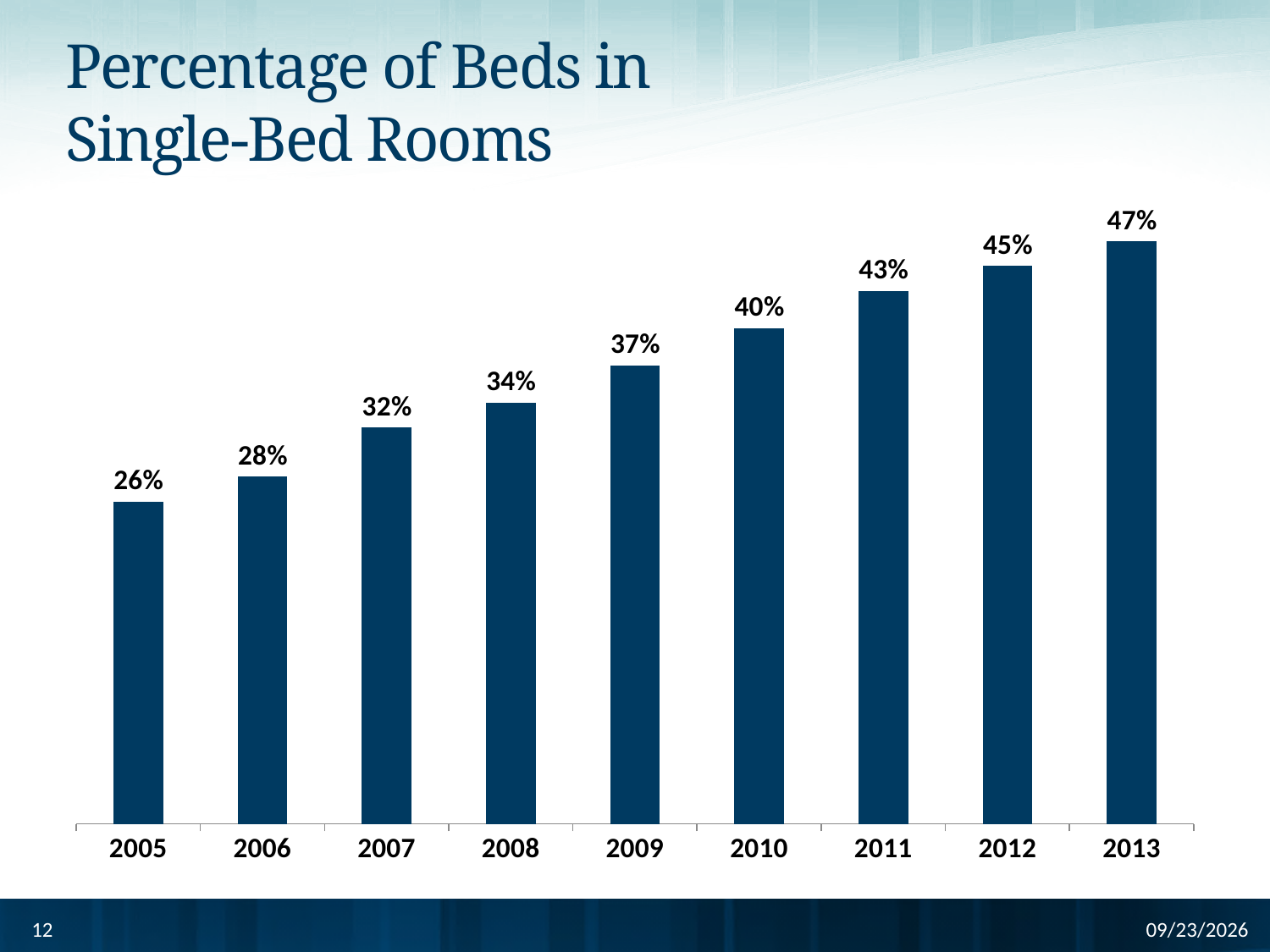
What kind of chart is shown on the slide? Bar chart What is the difference in percentage points between 2009 and 2008? 3 Which year has a higher percentage, 2007 or 2011? 2011 What is the difference in percentage points between 2013 and 2005? 21 Which year has the lowest percentage of beds in single-bed rooms? 2005 What is the percentage of beds in single-bed rooms in 2010? 40% What is the percentage of beds in single-bed rooms in 2005? 26% Which year has the highest percentage of beds in single-bed rooms? 2013 What is the percentage of beds in single-bed rooms in 2013? 47% How many years are shown on the chart? 9 Do the values rise or fall from 2005 to 2013? Rise What is the title of the slide? Percentage of Beds in Single-Bed Rooms